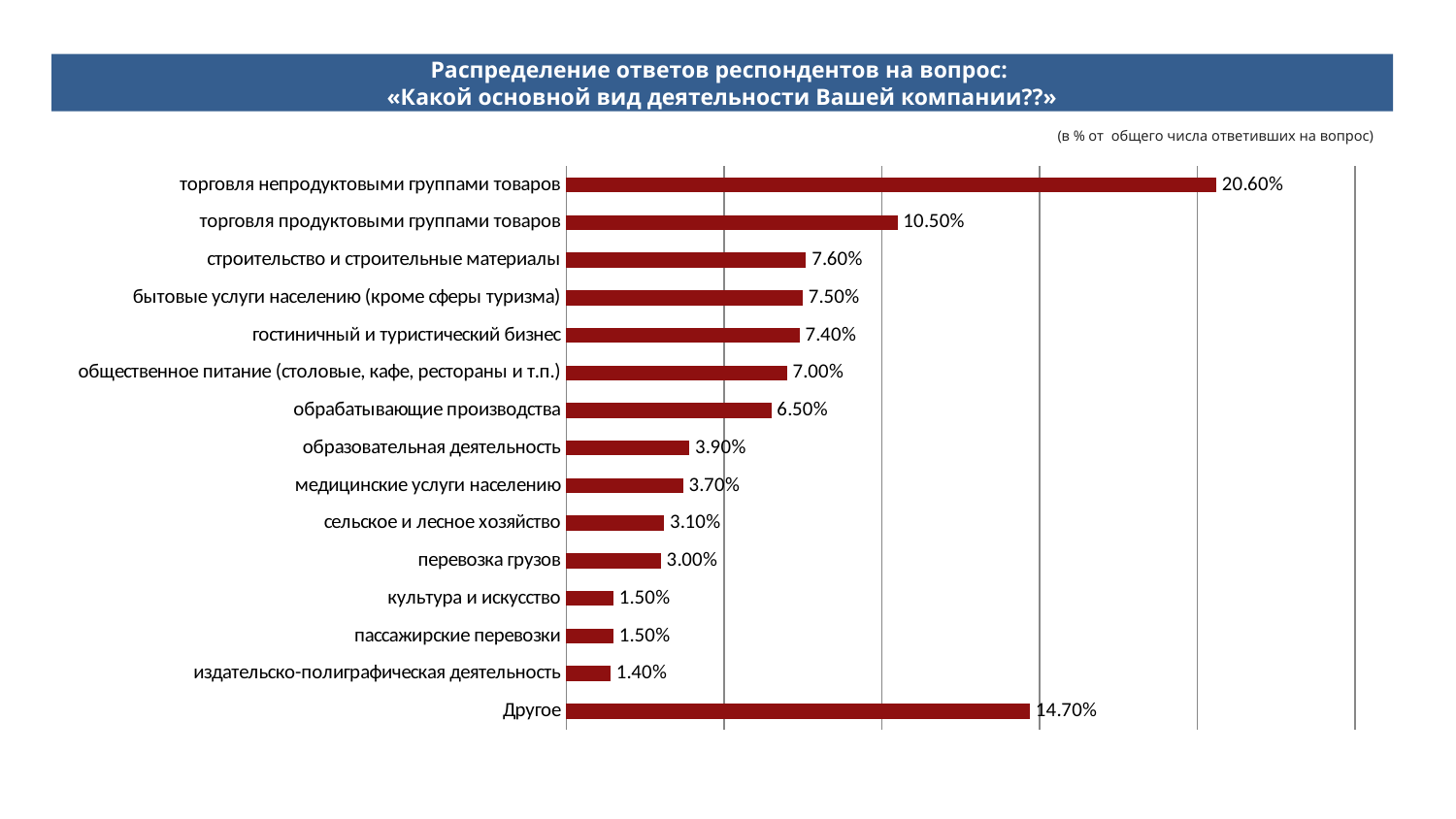
Which category has the highest value? торговля непродуктовыми группами товаров What type of chart is shown on the slide? bar chart What is the value for «перевозка грузов»? 3.00% What is the value for «торговля непродуктовыми группами товаров»? 20.60% Which is larger: «образовательная деятельность» or «медицинские услуги населению»? образовательная деятельность What is the difference between «торговля непродуктовыми группами товаров» and «торговля продуктовыми группами товаров»? 10.10% What is the difference between «Другое» and «обрабатывающие производства»? 8.20% How many categories are shown in the chart? 15 According to the note above the chart, in what units are the values expressed? в % от общего числа ответивших на вопрос Which category has the lowest value? издательско-полиграфическая деятельность What is the value for «Другое»? 14.70% What is the value for «обрабатывающие производства»? 6.50%